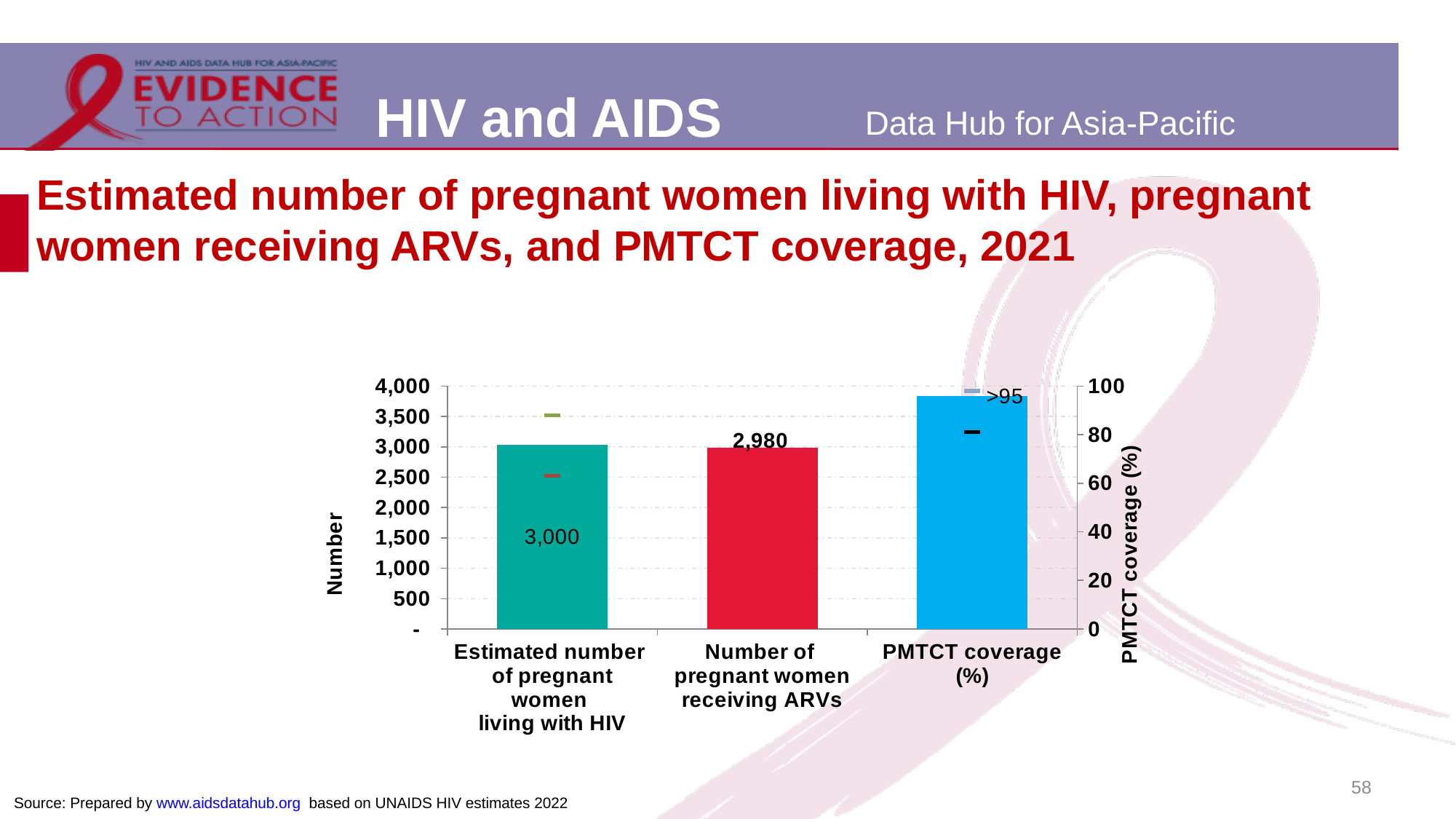
What PMTCT coverage (%) value is labelled on the chart? >95 What is the label of the left-hand vertical axis? Number What is the estimated number of pregnant women living with HIV shown on the chart? 3,000 What is the number of pregnant women receiving ARVs shown on the chart? 2,980 How many bars are plotted on the chart? 3 What type of chart is shown on the slide? Bar chart Is the bar for the number of pregnant women receiving ARVs greater or less than 3,500 on the left-hand axis? less What is the label of the right-hand vertical axis? PMTCT coverage (%) Is the PMTCT coverage (%) bar greater or less than 80 on the right-hand axis? greater Which is larger: the estimated number of pregnant women living with HIV or the number of pregnant women receiving ARVs? Estimated number of pregnant women living with HIV